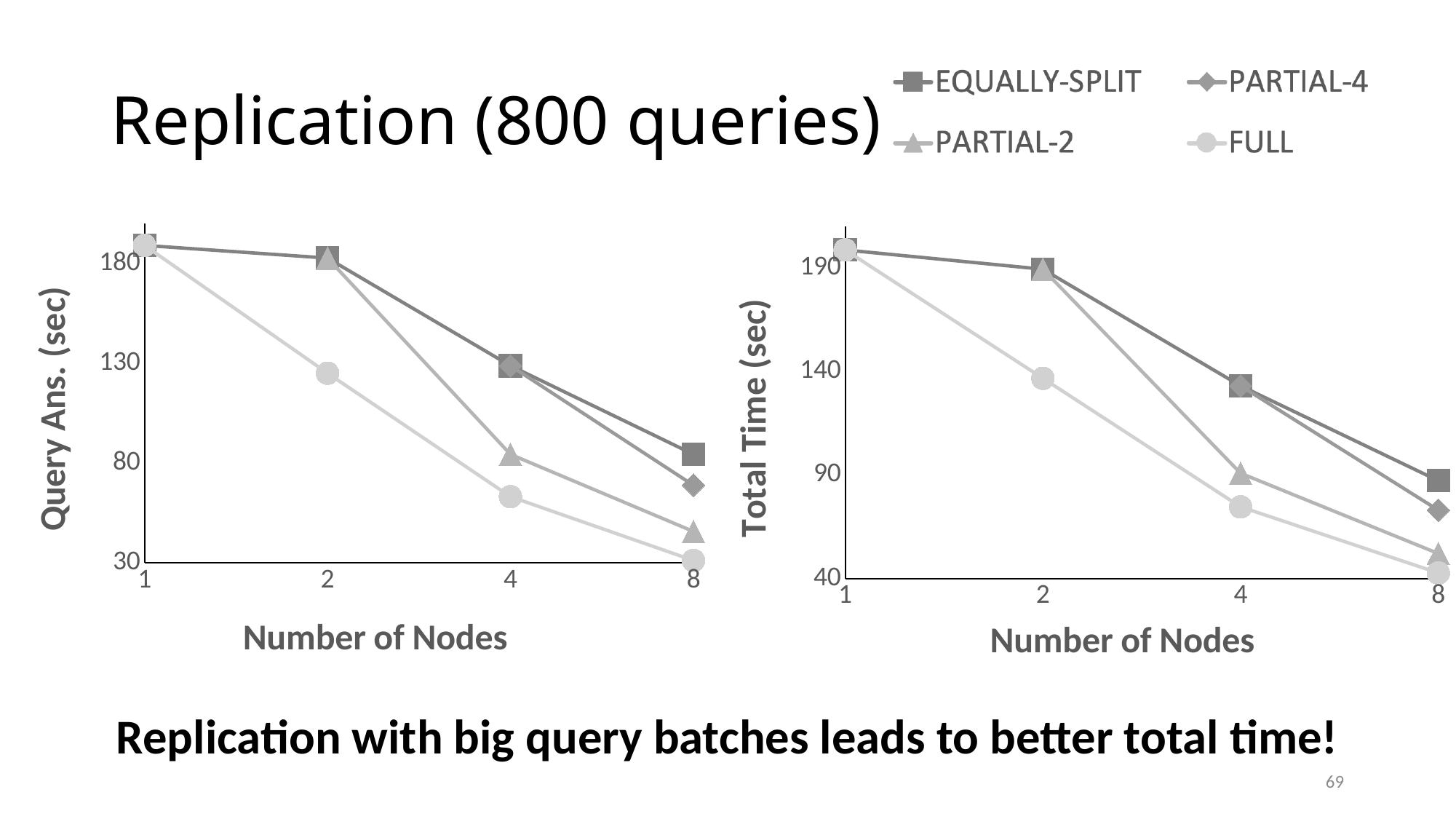
In the left chart (Query Ans. (sec)), is the value for PARTIAL-4 at 8 nodes greater or less than 80? less How many series does the legend list? 4 In the right chart (Total Time (sec)), is the value for EQUALLY-SPLIT at 4 nodes greater or less than 140? less In the left chart (Query Ans. (sec)), which series has the lowest value at 8 nodes? FULL In the left chart (Query Ans. (sec)), at 4 nodes, which is larger: PARTIAL-2 or FULL? PARTIAL-2 What is the x-axis label of the right chart? Number of Nodes In the right chart (Total Time (sec)), does the FULL series rise or fall as the number of nodes increases? fall In the right chart (Total Time (sec)), is the value for PARTIAL-4 at 8 nodes greater or less than 90? less What kind of chart is the left chart (Query Ans. (sec))? line chart In the left chart (Query Ans. (sec)), how many node counts are plotted along the x axis? 4 In the right chart (Total Time (sec)), which series has the highest value at 8 nodes? EQUALLY-SPLIT